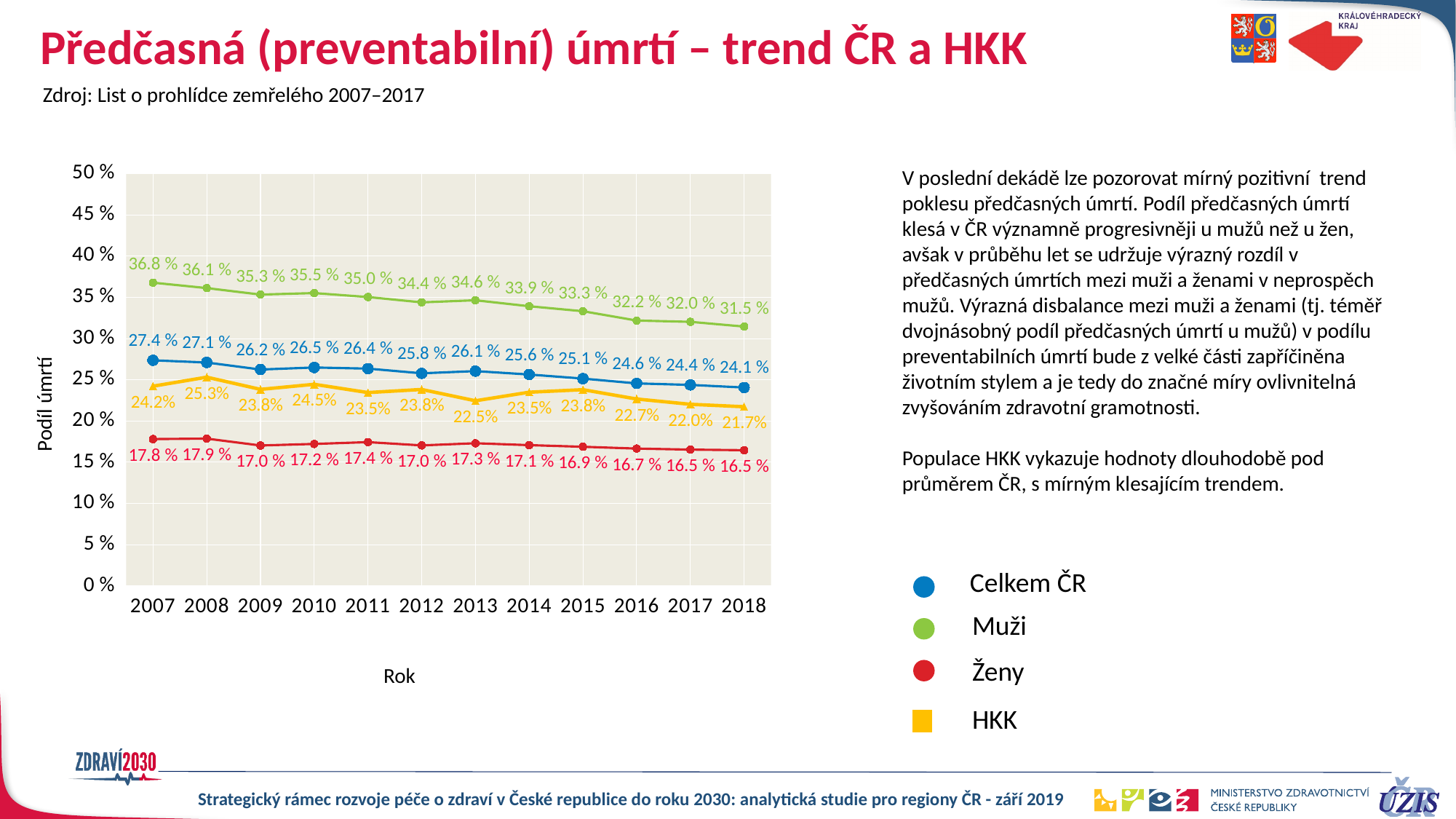
What kind of chart is shown on the slide? Line chart What is the value for Muži in 2007? 36.8 % What is the value for HKK in 2018? 21.7% What is the difference between the Muži and Ženy values in 2018? 15.0 percentage points How many series does the legend list? 4 In which year is the value for Muži highest? 2007 In which year is the value for HKK lowest? 2018 How many years are shown on the x axis? 12 What is the value for Celkem ČR in 2010? 26.5 % What is the value for Ženy in 2013? 17.3 % Do the values for Muži rise or fall from 2007 to 2018? Fall In 2015, which is larger: the value for Celkem ČR or for HKK? Celkem ČR